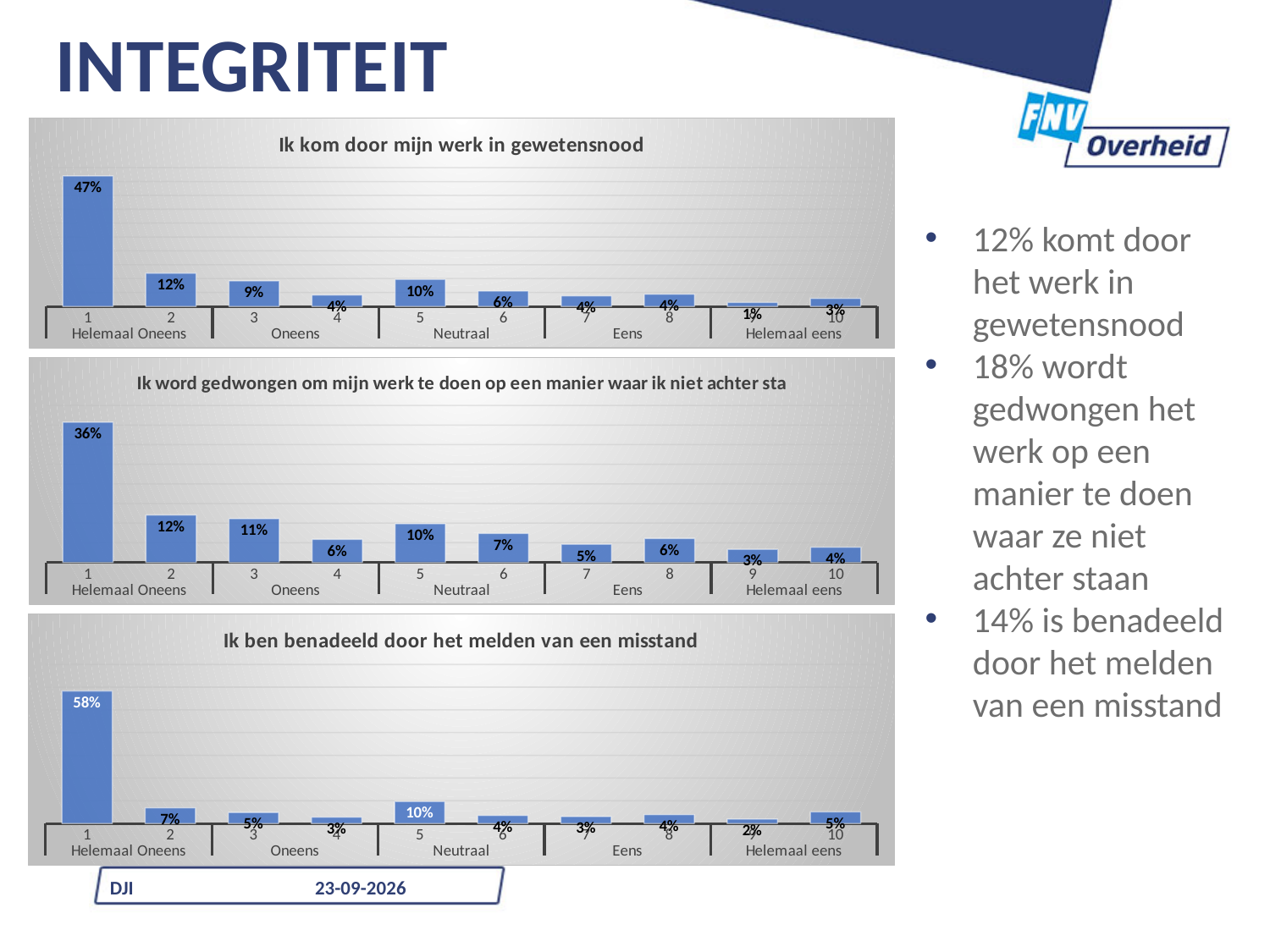
In the chart 'Ik ben benadeeld door het melden van een misstand', what is the difference between the values for category 5 and category 2? 3% In the chart 'Ik ben benadeeld door het melden van een misstand', what is the value for category 1? 58% How many charts are shown on the slide? 3 In the chart 'Ik kom door mijn werk in gewetensnood', what is the value for category 1? 47% In the chart 'Ik kom door mijn werk in gewetensnood', what is the difference between the values for category 1 and category 2? 35% In the chart 'Ik kom door mijn werk in gewetensnood', which category has the lowest value? 9 In the chart 'Ik word gedwongen om mijn werk te doen op een manier waar ik niet achter sta', which is larger: the value for category 3 or category 6? category 3 In the chart 'Ik word gedwongen om mijn werk te doen op een manier waar ik niet achter sta', which category has the highest value? 1 In the chart 'Ik word gedwongen om mijn werk te doen op een manier waar ik niet achter sta', what is the value for category 5? 10% How many categories are plotted in the chart 'Ik ben benadeeld door het melden van een misstand'? 10 What kind of chart is 'Ik kom door mijn werk in gewetensnood'? bar chart In the chart 'Ik ben benadeeld door het melden van een misstand', what is the value for category 10? 5%